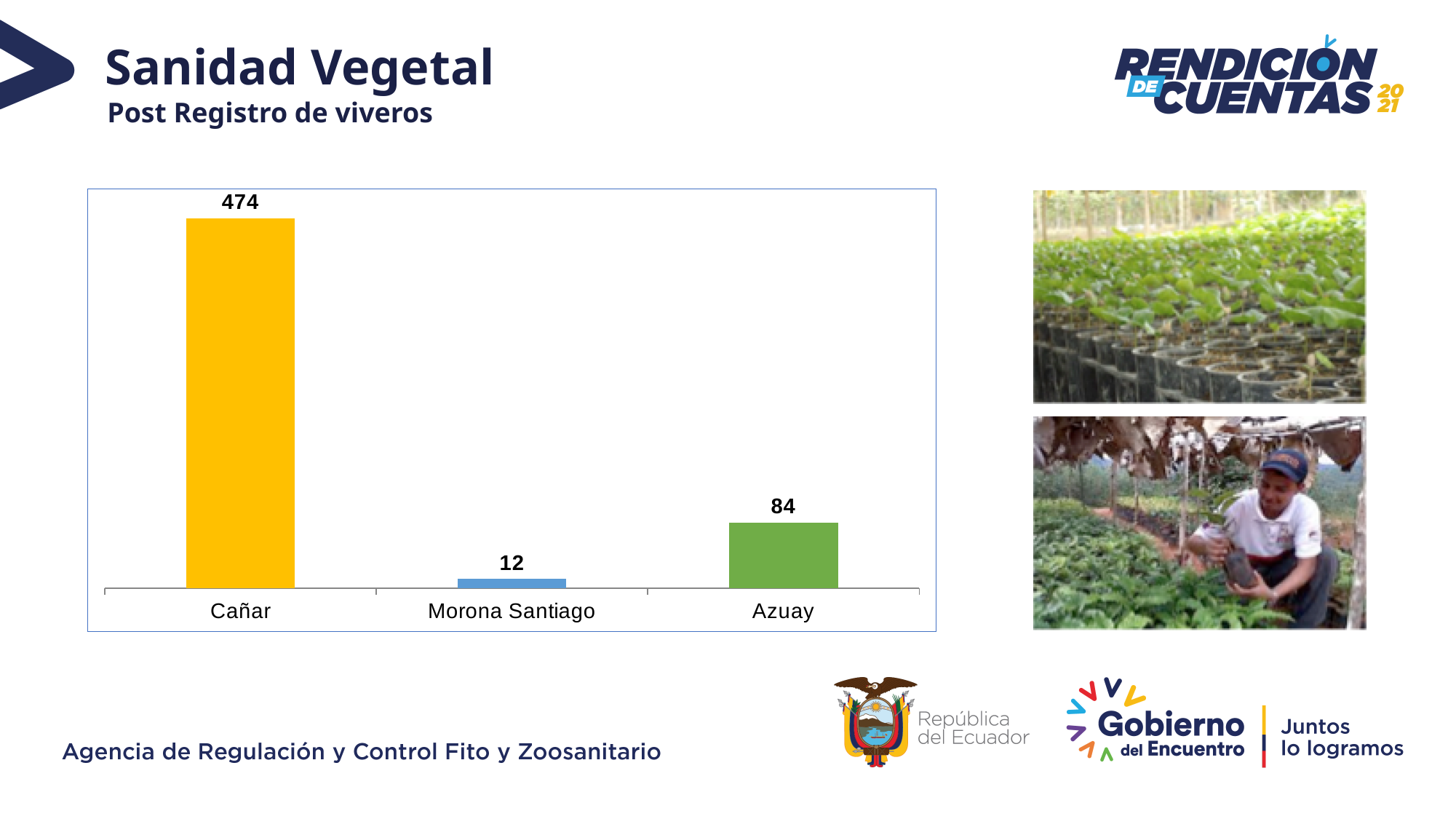
What is the value for Morona Santiago? 12 What is the difference between the values for Azuay and Morona Santiago? 72 What is the value for Cañar? 474 What colour is the bar for Cañar? Yellow What is the difference between the values for Cañar and Azuay? 390 How many categories are shown in the chart? 3 Which is larger, the value for Azuay or the value for Morona Santiago? Azuay What is the total of the three values shown in the chart? 570 What kind of chart is shown on the slide? Bar chart Which category has the lowest value? Morona Santiago Which category has the highest value? Cañar What is the value for Azuay? 84